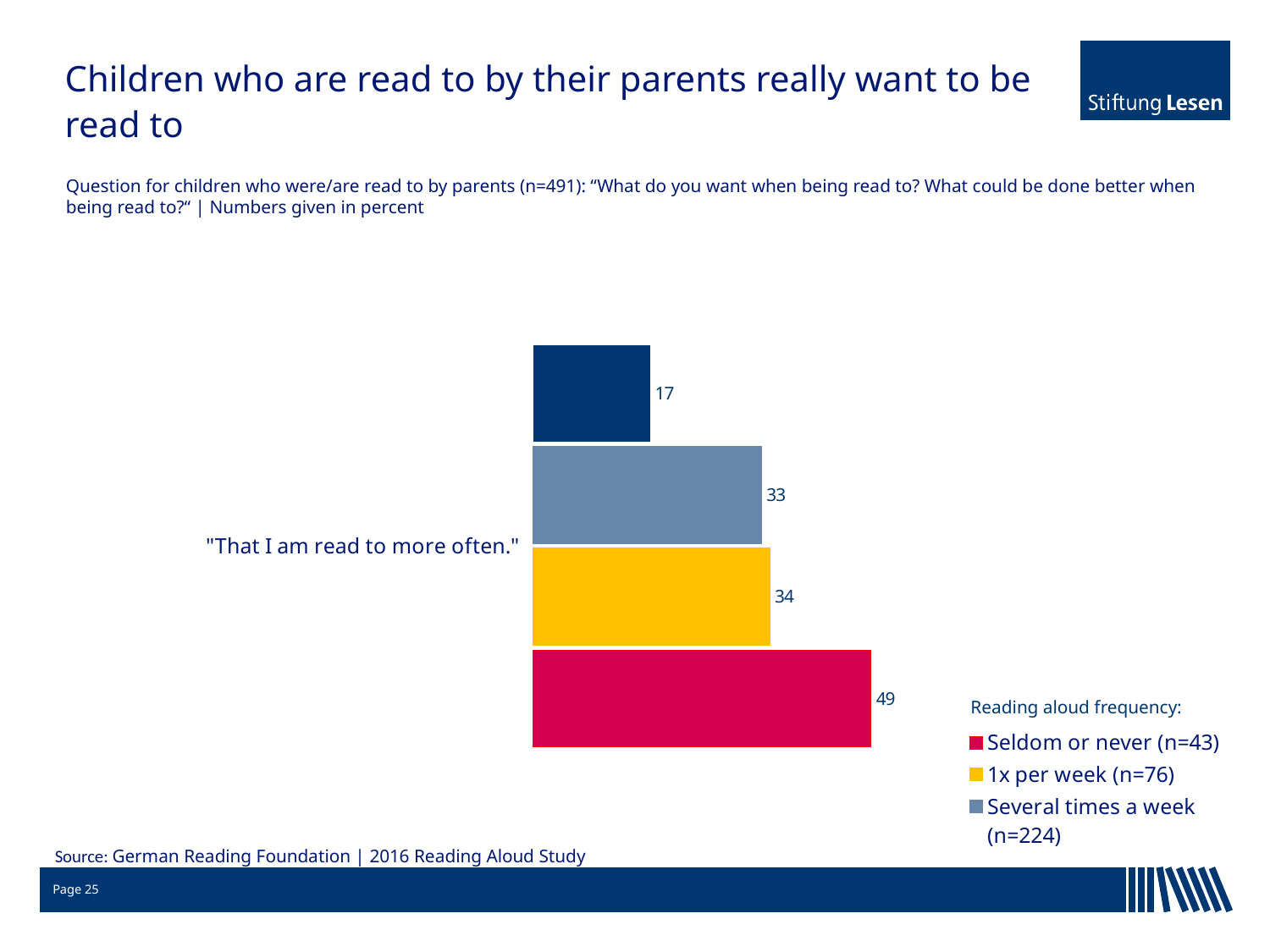
What value is printed on the dark blue bar at the top of the chart? 17 How many series does the legend list? 3 Which has the larger value, "1x per week (n=76)" or "Several times a week (n=224)"? 1x per week (n=76) What is the value for "1x per week (n=76)" for "That I am read to more often."? 34 What is the difference between the values for "Seldom or never (n=43)" and "1x per week (n=76)"? 15 Which reading aloud frequency group listed in the legend has the highest value? Seldom or never (n=43) How many bars are plotted in the chart? 4 What is the difference between the values for "Seldom or never (n=43)" and "Several times a week (n=224)"? 16 What is the lowest value shown on any bar in the chart? 17 What is the value for "Several times a week (n=224)" for "That I am read to more often."? 33 What kind of chart is shown on the slide? Bar chart What is the value for "Seldom or never (n=43)" for "That I am read to more often."? 49